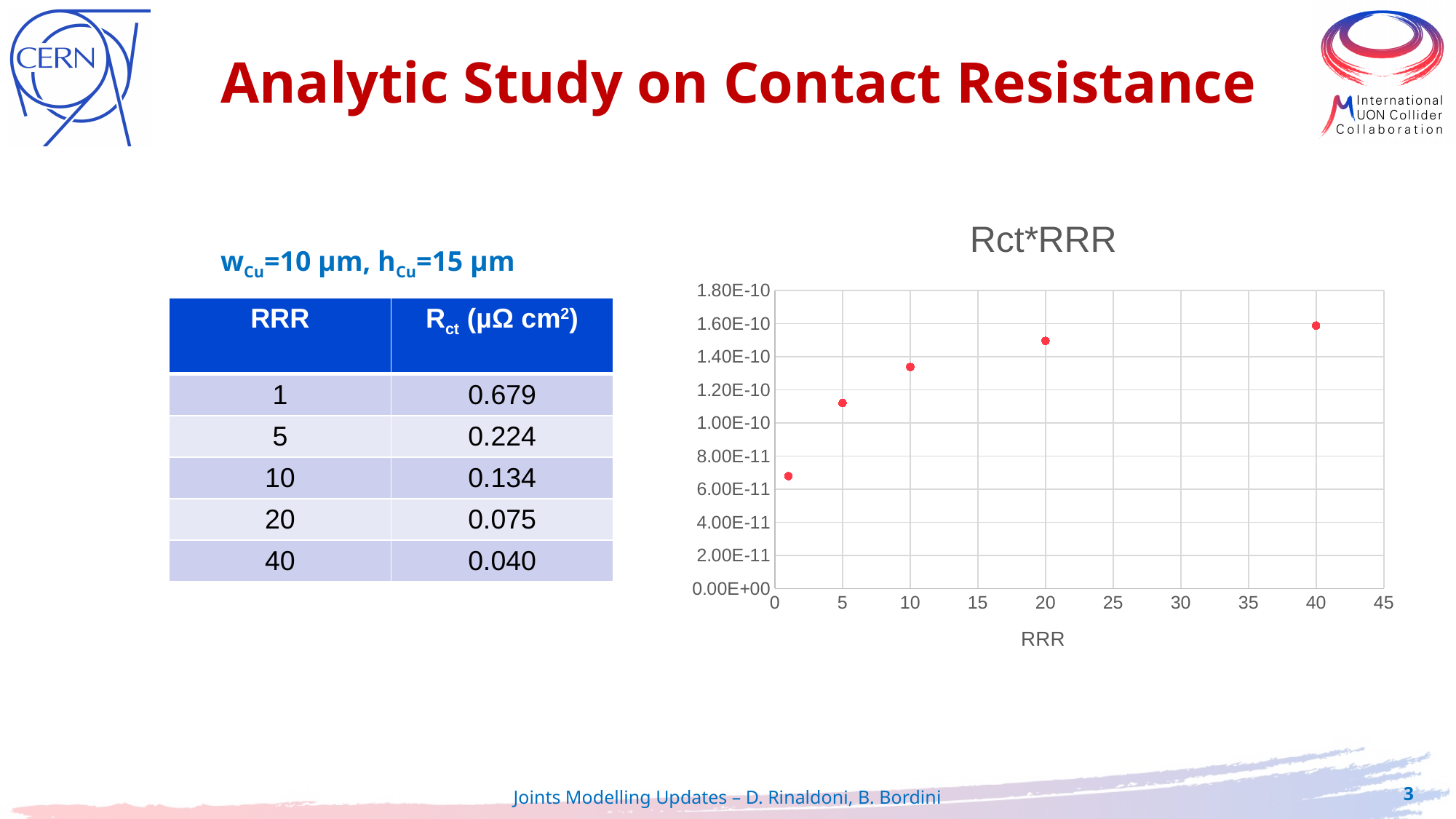
What is the label of the x axis of the chart? RRR Is the plotted value at RRR = 5 greater or less than 1.00E-10? greater How many data points are plotted in the chart? 5 What is the title of the chart? Rct*RRR What kind of chart is shown on the slide? scatter chart At which RRR value is the plotted Rct*RRR highest? 40 At which RRR value is the plotted Rct*RRR lowest? 1 Is the plotted value at RRR = 1 greater or less than 8.00E-11? less Which has the larger plotted value, RRR = 5 or RRR = 10? RRR = 10 Is the plotted value at RRR = 40 greater or less than 1.40E-10? greater Do the plotted values rise or fall as RRR increases along the x axis? rise